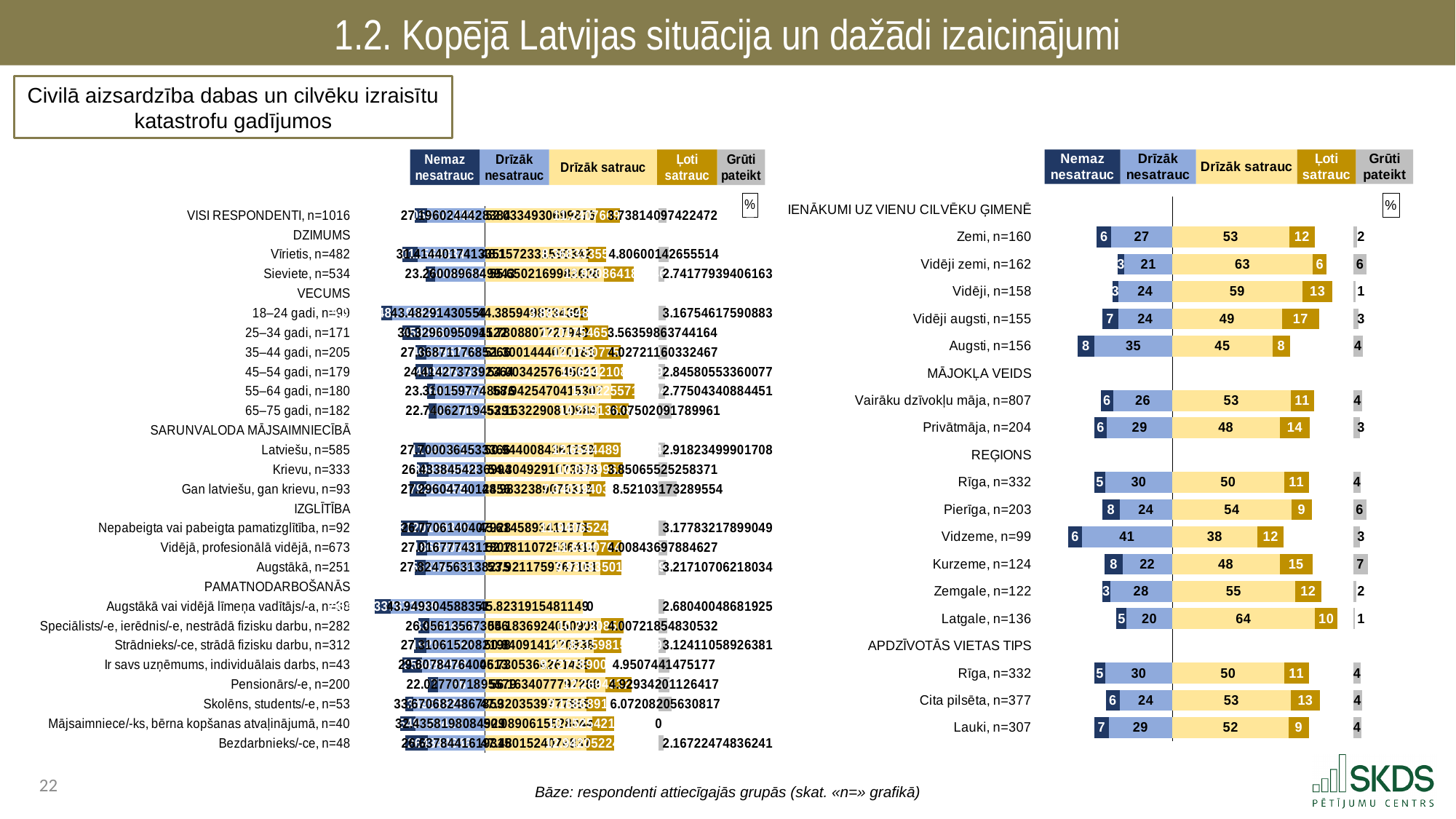
In the right chart, what is the total of the stacked bar for Zemi, n=160? 100 In the right chart, which income group under IENĀKUMI UZ VIENU CILVĒKU ĢIMENĒ has the lowest 'Drīzāk satrauc' value? Augsti, n=156 What kind of chart is the right chart? Stacked bar chart In the right chart, which has the larger 'Ļoti satrauc' value: Kurzeme, n=124 or Pierīga, n=203? Kurzeme, n=124 In the right chart, what is the value for 'Ļoti satrauc' for Vidēji augsti, n=155? 17 How many series does the legend of the right chart list? 5 In the right chart, what is the value for 'Drīzāk satrauc' for Latgale, n=136? 64 In the right chart, what is the value for 'Grūti pateikt' for Kurzeme, n=124? 7 What is the title shown in the box at the top left of the slide? Civilā aizsardzība dabas un cilvēku izraisītu katastrofu gadījumos In the right chart, how many regions are listed under the REĢIONS group? 6 In the right chart, which region under REĢIONS has the highest 'Drīzāk nesatrauc' value? Vidzeme, n=99 In the right chart, what is the difference between the 'Drīzāk satrauc' values for Latgale, n=136 and Vidzeme, n=99? 26